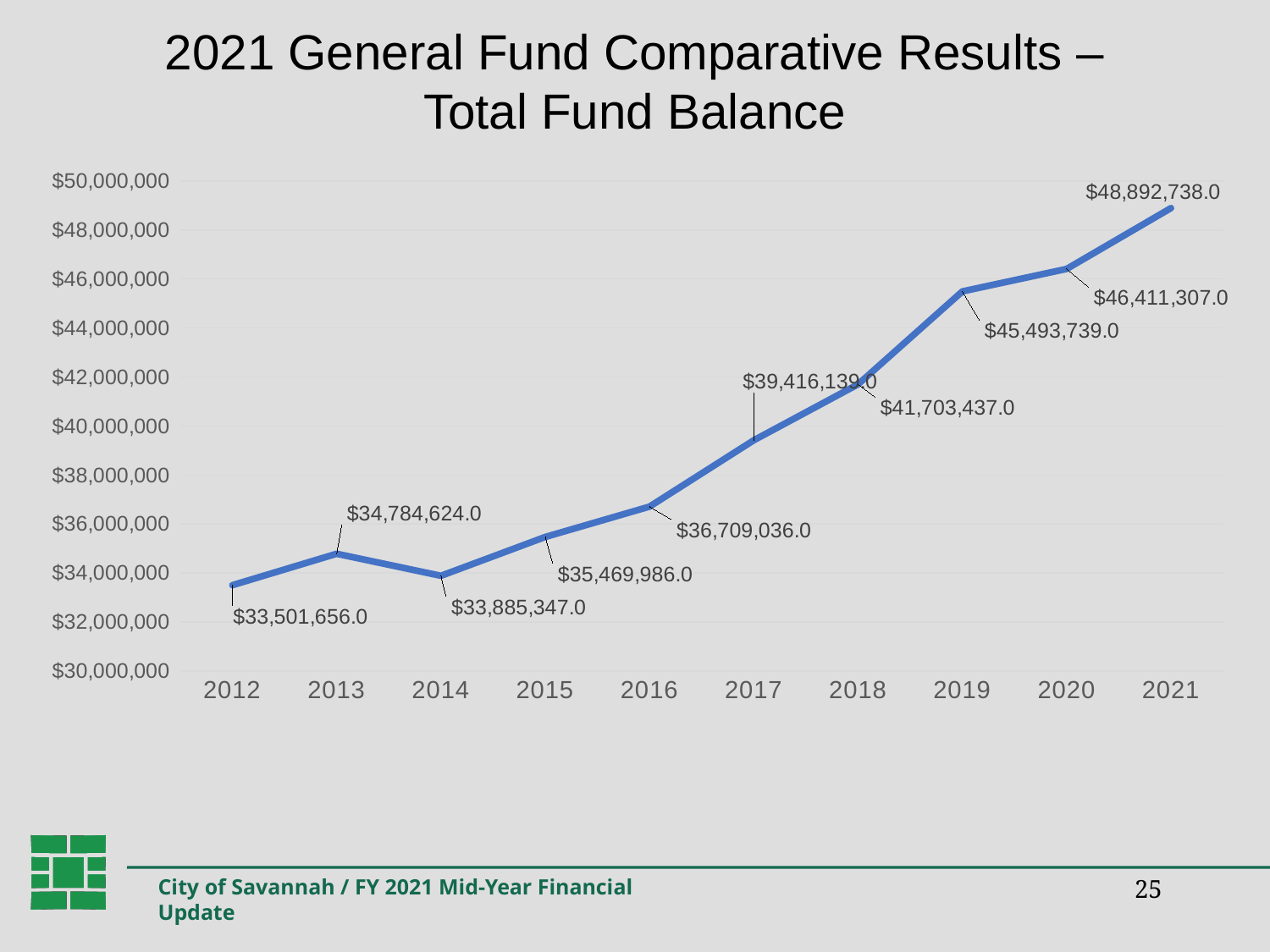
What kind of chart is shown on the slide? Line chart What is the total fund balance for 2012? $33,501,656.0 What is the total fund balance for 2019? $45,493,739.0 Overall, does the total fund balance rise or fall from 2012 to 2021? Rise How many years are plotted on the chart? 10 What is the total fund balance for 2016? $36,709,036.0 What is the difference between the total fund balance in 2021 and in 2020? $2,481,431.0 Is the total fund balance for 2018 greater or less than $40,000,000? greater Is the total fund balance for 2013 or 2014 larger? 2013 Which year has the lowest total fund balance? 2012 What is the total fund balance for 2021? $48,892,738.0 Which year has the highest total fund balance? 2021